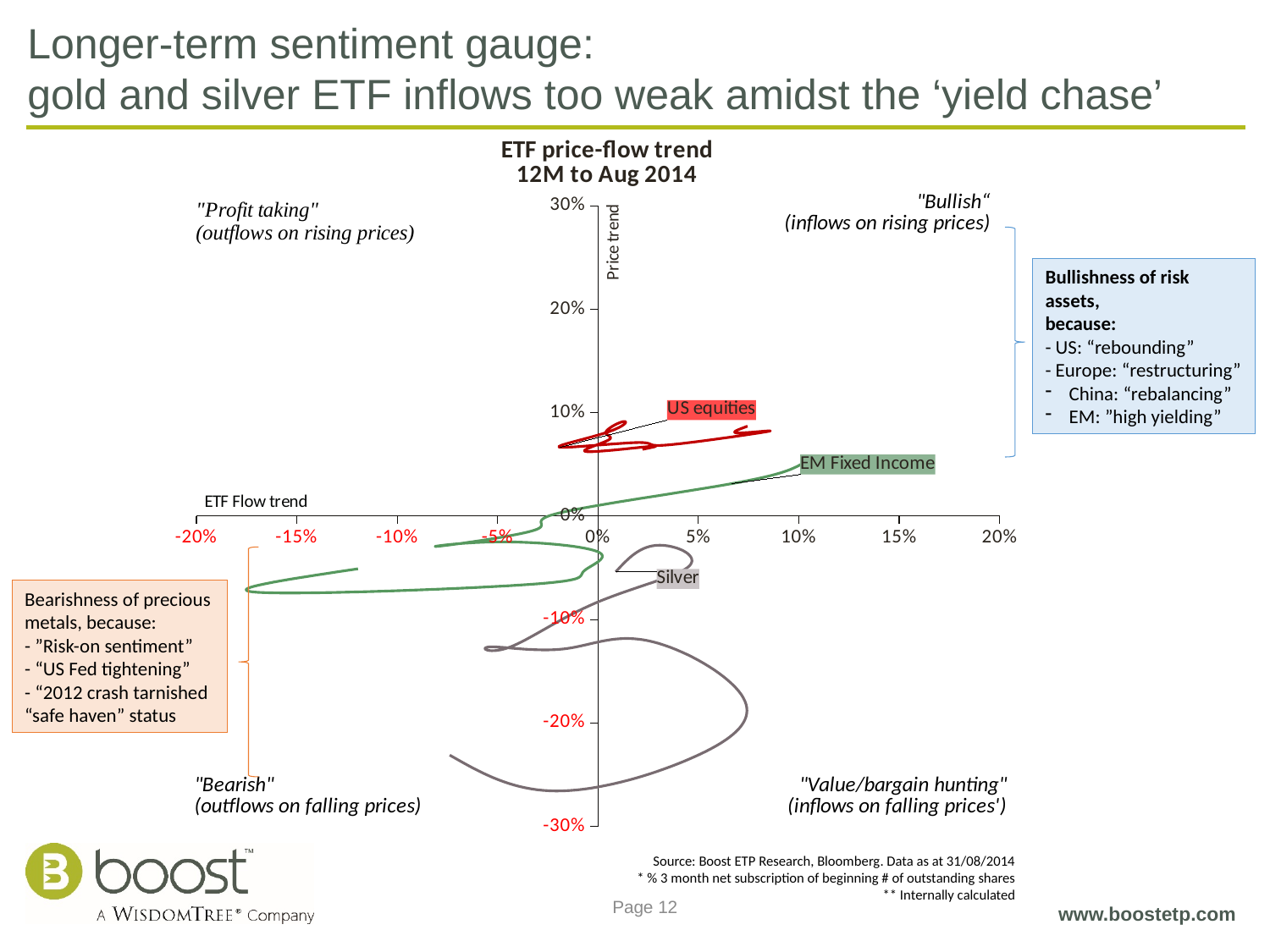
How many named series (assets) are plotted on the chart? 3 What is the highest value shown on the price trend (vertical) axis? 30% What is the title of the chart? ETF price-flow trend 12M to Aug 2014 Is the lowest price trend reached by Silver greater or less than -20%? less What is the label of the vertical axis? Price trend Is the latest price trend for Silver greater or less than 0%? less What kind of chart is shown on the slide? Scatter (line) chart What is the lowest value shown on the ETF Flow trend (horizontal) axis? -20% Which plotted series reaches the lowest price trend on the chart? Silver Is the latest price trend for US equities greater or less than 0%? greater Which plotted series reaches the highest price trend on the chart? US equities